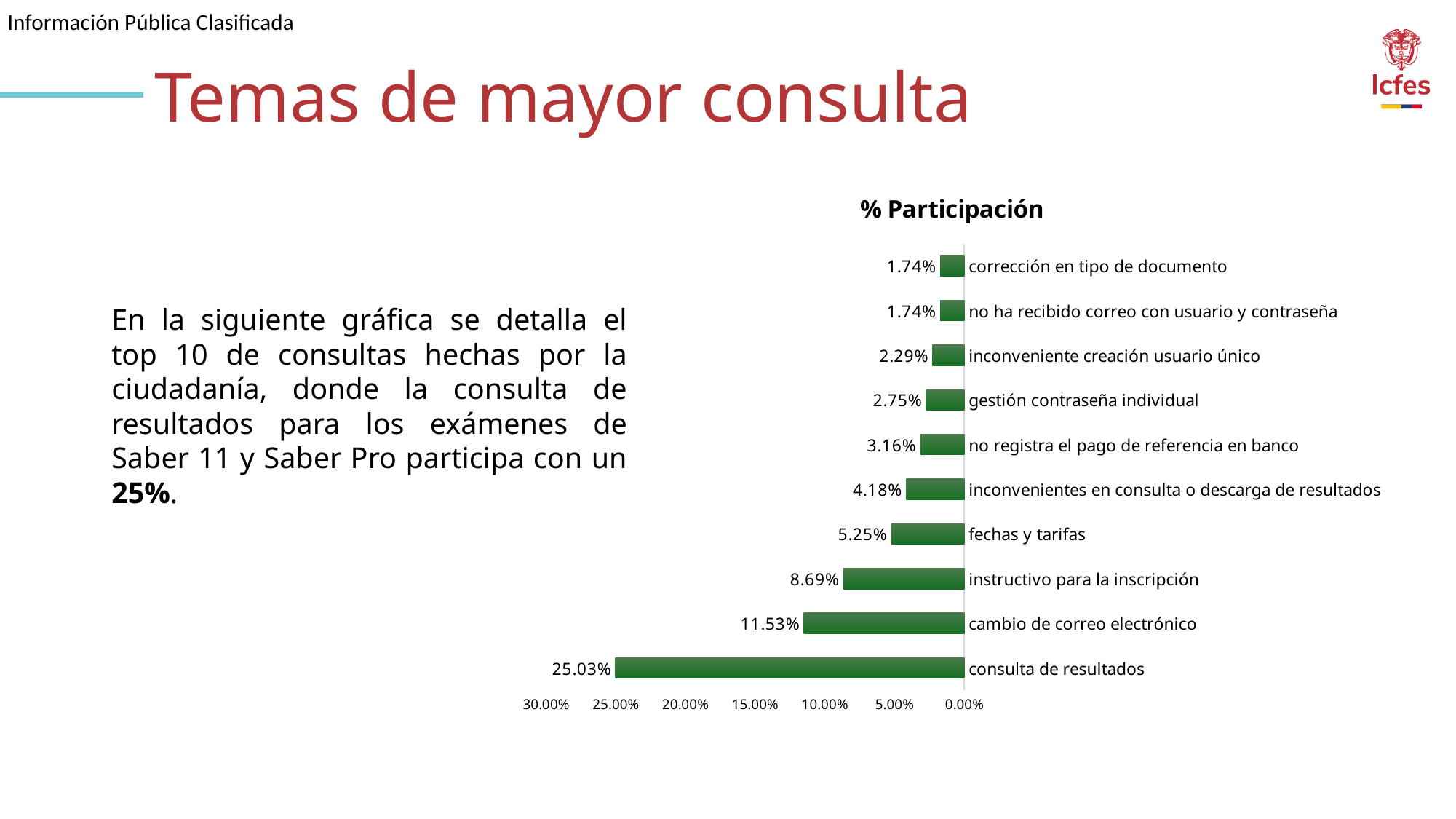
How many categories are shown in the chart? 10 What kind of chart is shown on the slide? bar chart Which category has the highest value? consulta de resultados What is the title of the chart? % Participación What is the value for 'cambio de correo electrónico'? 11.53% What is the difference between 'consulta de resultados' and 'cambio de correo electrónico'? 13.50% What is the value for 'fechas y tarifas'? 5.25% Which is larger: 'gestión contraseña individual' or 'inconveniente creación usuario único'? gestión contraseña individual Is the value for 'instructivo para la inscripción' greater or less than 10.00%? less What is the value for 'consulta de resultados'? 25.03% What is the difference between 'instructivo para la inscripción' and 'fechas y tarifas'? 3.44% What is the value for 'no registra el pago de referencia en banco'? 3.16%